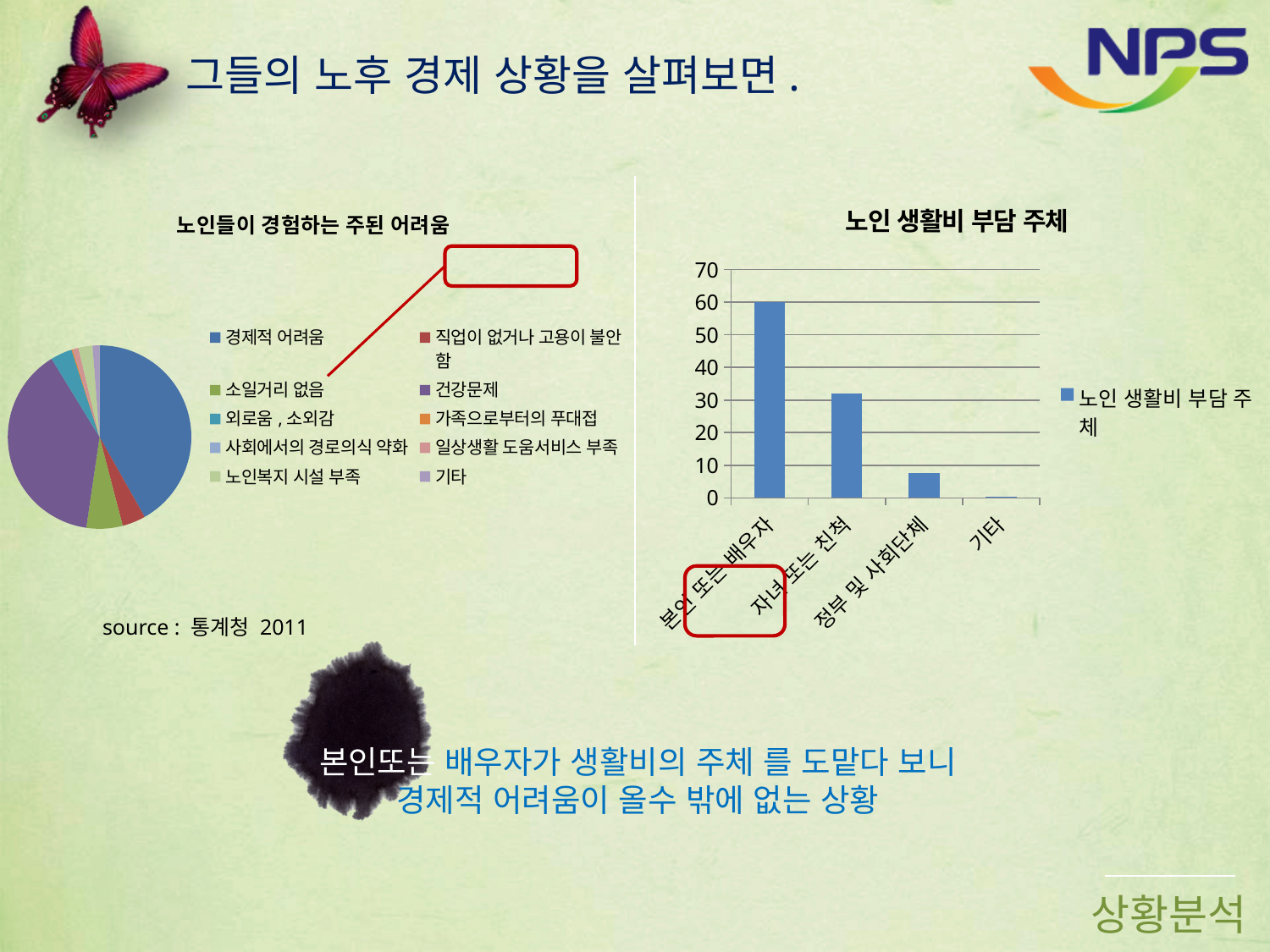
In the '노인 생활비 부담 주체' chart, which is larger: 자녀 또는 친척 or 정부 및 사회단체? 자녀 또는 친척 What kind of chart is the '노인 생활비 부담 주체' chart on the right? bar chart In the '노인 생활비 부담 주체' chart, which category has the lowest value? 기타 How many categories are shown on the x axis of the '노인 생활비 부담 주체' chart? 4 In the '노인 생활비 부담 주체' chart, which category has the highest value? 본인 또는 배우자 How many entries does the legend of the '노인들이 경험하는 주된 어려움' pie chart list? 10 In the '노인 생활비 부담 주체' chart, is the value for 본인 또는 배우자 greater or less than 50? greater In the '노인 생활비 부담 주체' chart, is the value for 자녀 또는 친척 greater or less than 40? less In the '노인 생활비 부담 주체' chart, is the value for 정부 및 사회단체 greater or less than 10? less How many series does the legend of the '노인 생활비 부담 주체' chart list? 1 What kind of chart is the '노인들이 경험하는 주된 어려움' chart on the left? pie chart In the '노인 생활비 부담 주체' chart, do the values rise or fall from left to right along the x axis? fall